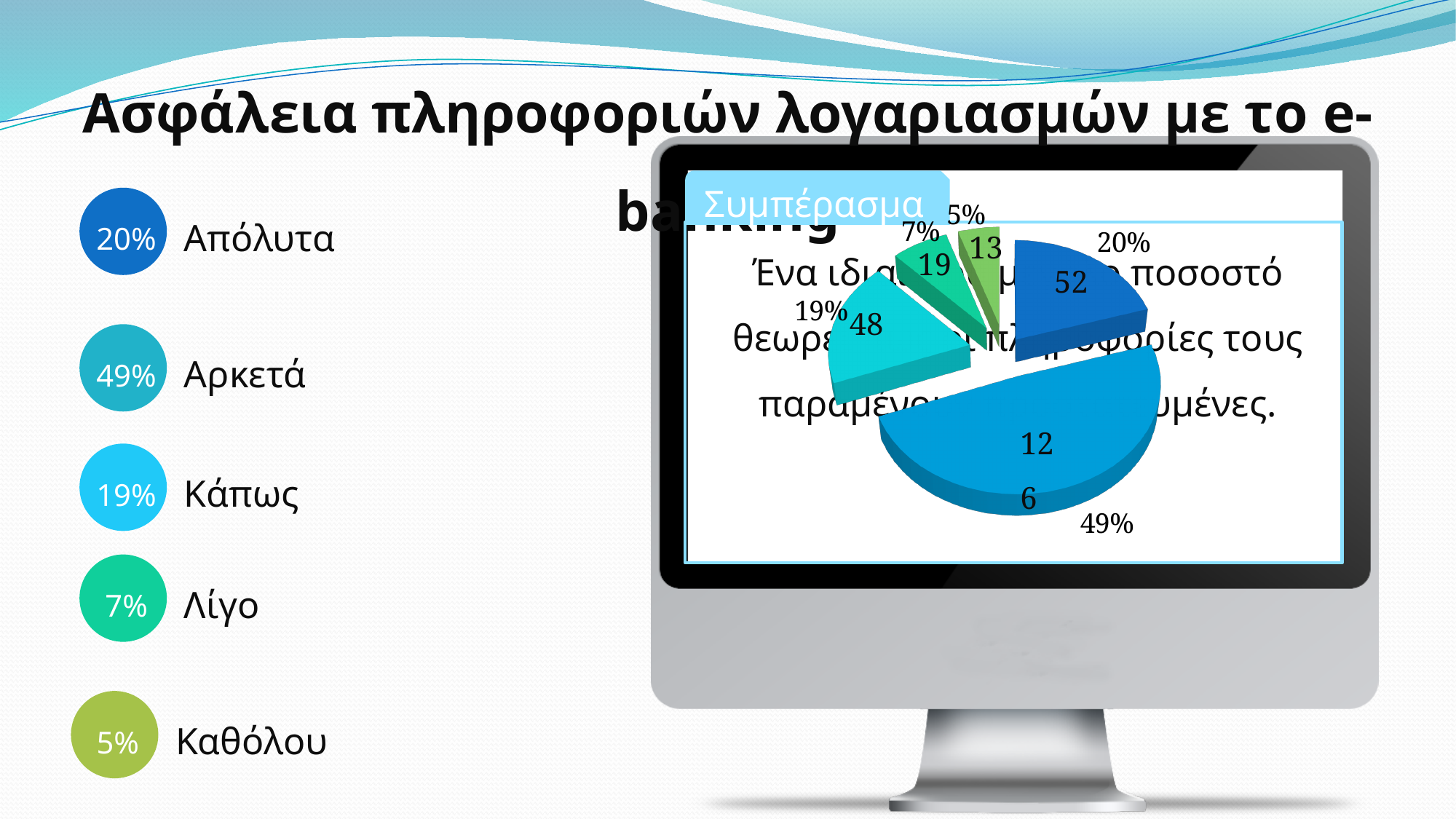
Which slice is larger, Κάπως or Λίγο? Κάπως What share of the pie does the Καθόλου slice represent? 5% What share of the pie does the Αρκετά slice represent? 49% What colour is the Καθόλου slice of the pie? green What kind of chart is shown on the slide? pie chart What share of the pie does the Λίγο slice represent? 7% What is the difference in percentage points between the Αρκετά slice and the Απόλυτα slice? 29 Which category has the largest slice of the pie? Αρκετά How many slices does the pie chart have? 5 Which category has the smallest slice of the pie? Καθόλου